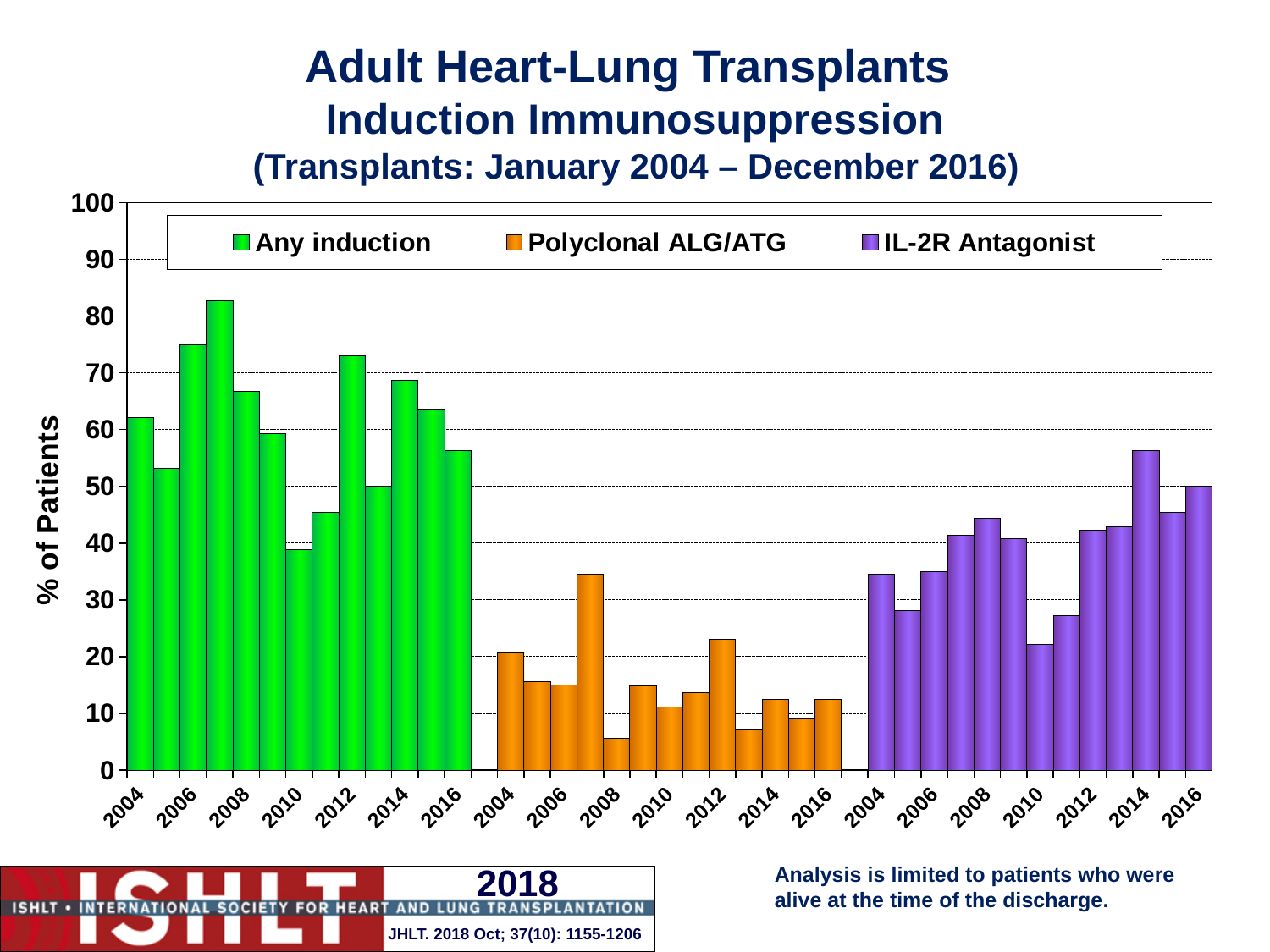
In which year is the Polyclonal ALG/ATG value highest? 2007 In which year is the Any induction value highest? 2007 Which year has the larger IL-2R Antagonist value, 2010 or 2014? 2014 Is the Polyclonal ALG/ATG value for 2008 greater or less than 10? less In which year is the IL-2R Antagonist value lowest? 2010 In which year is the Polyclonal ALG/ATG value lowest? 2008 How many series does the legend list? 3 What kind of chart is shown on the slide? Bar chart Is the Any induction value for 2007 greater or less than 80? greater What is the label on the y axis? % of Patients In which year is the Any induction value lowest? 2010 In which year is the IL-2R Antagonist value highest? 2014